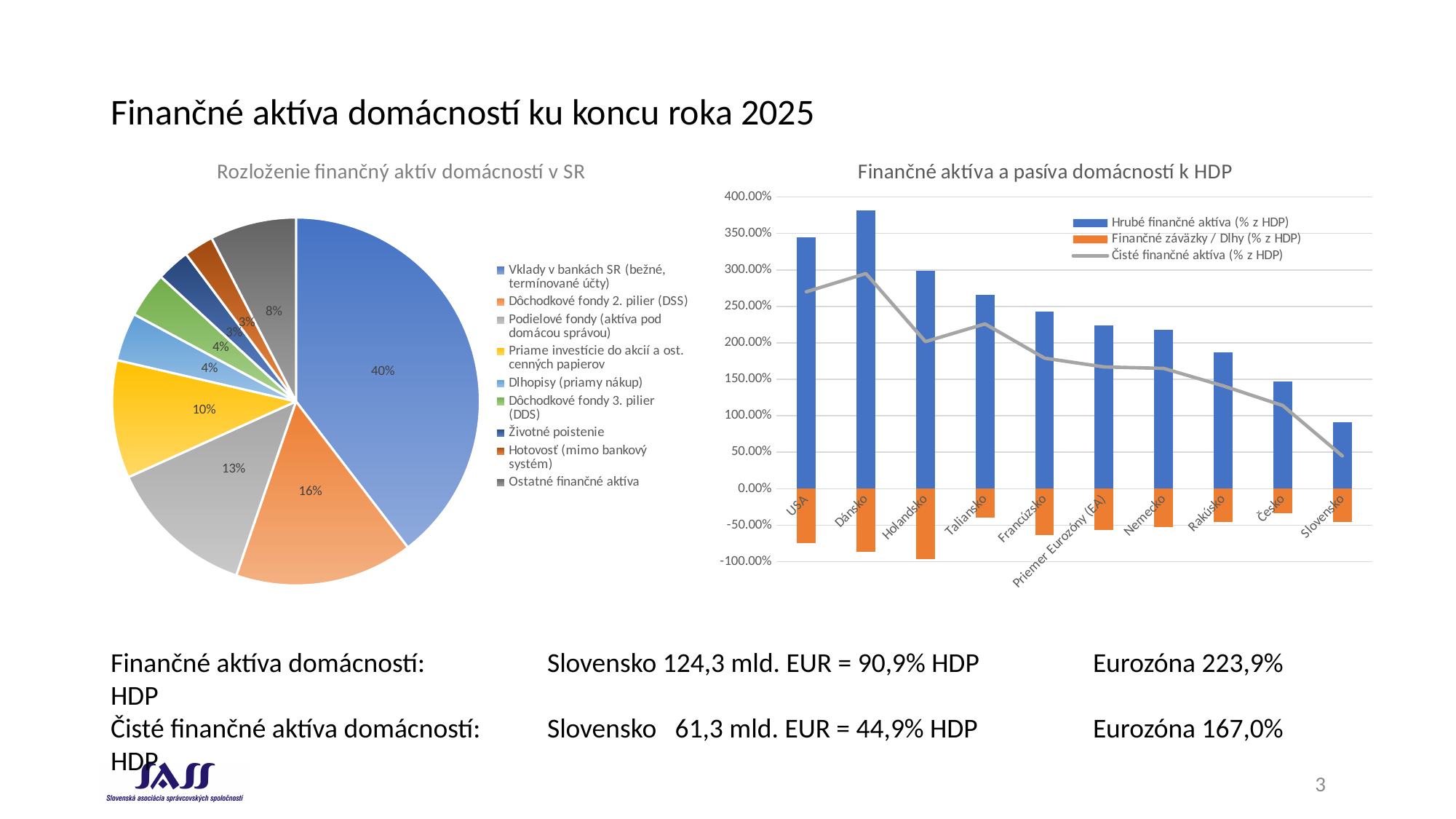
How many slices does the pie chart 'Rozloženie finančný aktív domácností v SR' have? 9 On the pie chart 'Rozloženie finančný aktív domácností v SR', what share is shown for 'Ostatné finančné aktíva'? 8% How many series does the legend of the chart 'Finančné aktíva a pasíva domácností k HDP' list? 3 On the pie chart 'Rozloženie finančný aktív domácností v SR', which category has the largest slice? Vklady v bankách SR (bežné, termínované účty) On the pie chart 'Rozloženie finančný aktív domácností v SR', which is larger: 'Podielové fondy (aktíva pod domácou správou)' or 'Priame investície do akcií a ost. cenných papierov'? Podielové fondy (aktíva pod domácou správou) On the chart 'Finančné aktíva a pasíva domácností k HDP', which country has the lowest 'Hrubé finančné aktíva (% z HDP)'? Slovensko On the chart 'Finančné aktíva a pasíva domácností k HDP', is the 'Hrubé finančné aktíva (% z HDP)' value for USA greater or less than 300.00%? greater On the pie chart 'Rozloženie finančný aktív domácností v SR', what is the difference in percentage points between 'Vklady v bankách SR' and 'Dôchodkové fondy 2. pilier (DSS)'? 24 percentage points On the pie chart 'Rozloženie finančný aktív domácností v SR', what share is shown for 'Vklady v bankách SR (bežné, termínované účty)'? 40% On the pie chart 'Rozloženie finančný aktív domácností v SR', what share is shown for 'Dôchodkové fondy 2. pilier (DSS)'? 16% On the chart 'Finančné aktíva a pasíva domácností k HDP', do the 'Hrubé finančné aktíva (% z HDP)' bars generally rise or fall from left to right? fall On the chart 'Finančné aktíva a pasíva domácností k HDP', which country has the highest 'Hrubé finančné aktíva (% z HDP)'? Dánsko